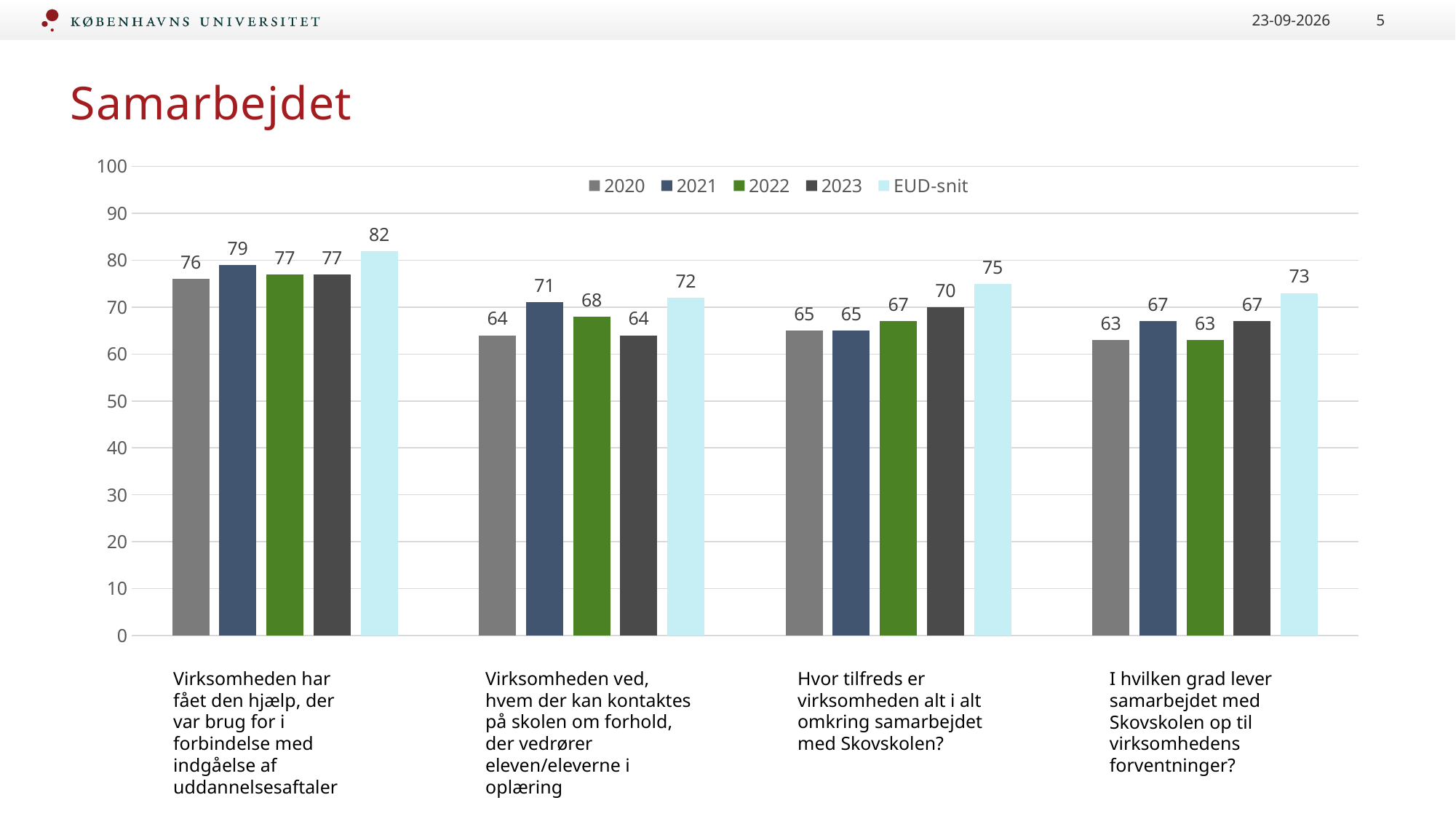
What kind of chart is shown on the slide? Bar chart Is the 2020 value for "I hvilken grad lever samarbejdet med Skovskolen op til virksomhedens forventninger?" greater or less than 70? less Which series has the highest value for "I hvilken grad lever samarbejdet med Skovskolen op til virksomhedens forventninger?"? EUD-snit Which is larger for "Virksomheden ved, hvem der kan kontaktes på skolen om forhold, der vedrører eleven/eleverne i oplæring": the 2021 value or the 2022 value? 2021 How many question categories are shown along the x axis? 4 Which series has the lowest value for "Virksomheden har fået den hjælp, der var brug for i forbindelse med indgåelse af uddannelsesaftaler"? 2020 What is the 2021 value for "Virksomheden ved, hvem der kan kontaktes på skolen om forhold, der vedrører eleven/eleverne i oplæring"? 71 What is the EUD-snit value for "Virksomheden har fået den hjælp, der var brug for i forbindelse med indgåelse af uddannelsesaftaler"? 82 What is the difference between the EUD-snit value and the 2023 value for "Hvor tilfreds er virksomheden alt i alt omkring samarbejdet med Skovskolen?"? 5 What is the 2023 value for "Hvor tilfreds er virksomheden alt i alt omkring samarbejdet med Skovskolen?"? 70 How many series does the legend list? 5 What is the title of the slide containing the chart? Samarbejdet